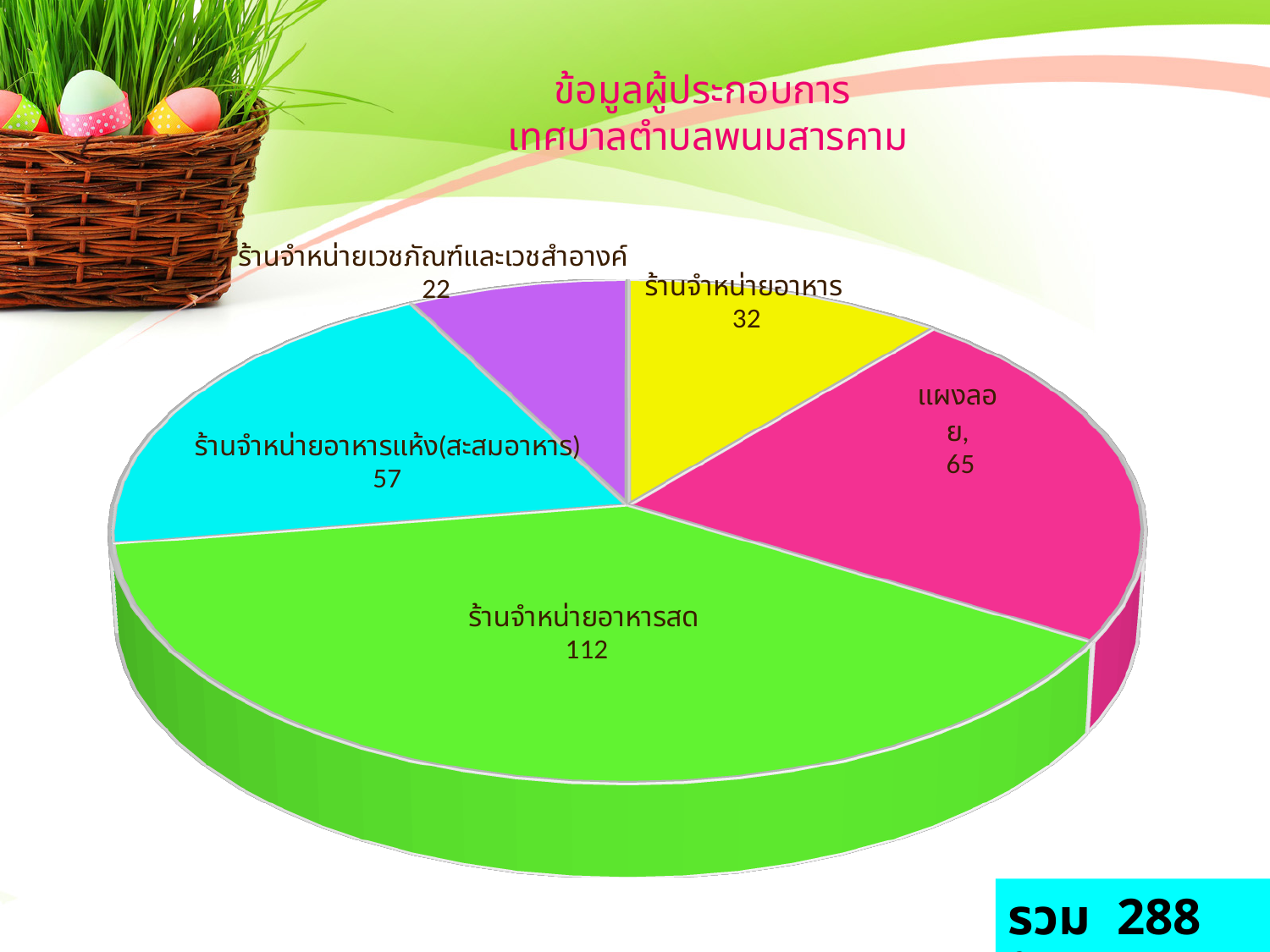
What is the value for ร้านจำหน่ายอาหารแห้ง(สะสมอาหาร)? 57 What kind of chart is shown on the slide? pie chart What is the difference between the values for ร้านจำหน่ายอาหารสด and แผงลอย? 47 What is the total shown for all categories (รวม)? 288 Which category has the largest slice of the pie? ร้านจำหน่ายอาหารสด What is the value for แผงลอย? 65 Which is larger, the value for ร้านจำหน่ายอาหาร or the value for ร้านจำหน่ายอาหารแห้ง(สะสมอาหาร)? ร้านจำหน่ายอาหารแห้ง(สะสมอาหาร) What is the value for ร้านจำหน่ายเวชภัณฑ์และเวชสำอางค์? 22 What is the title of the chart? ข้อมูลผู้ประกอบการ เทศบาลตำบลพนมสารคาม Which category has the smallest slice of the pie? ร้านจำหน่ายเวชภัณฑ์และเวชสำอางค์ What is the value for ร้านจำหน่ายอาหารสด? 112 How many categories are shown in the pie chart? 5